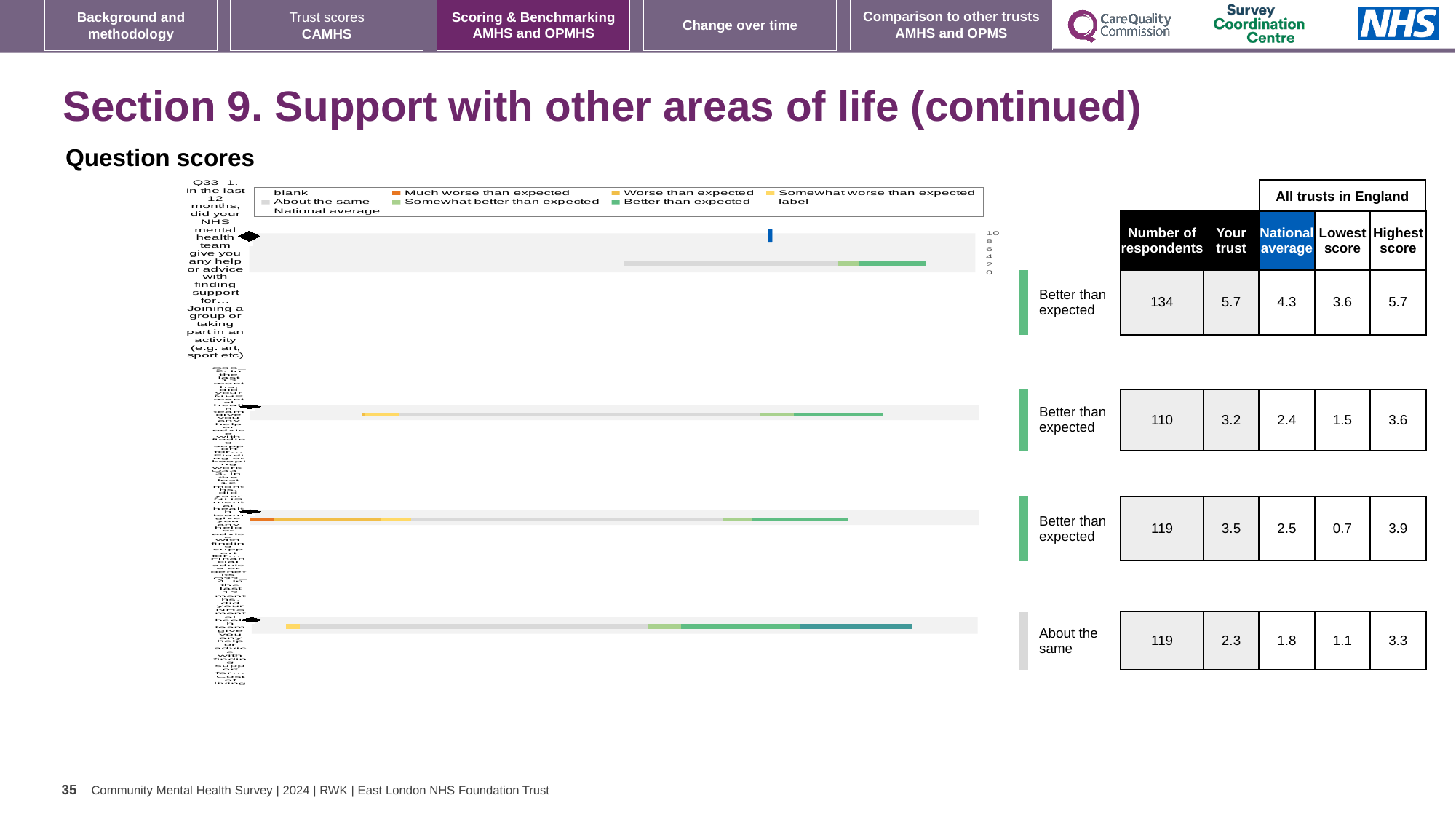
In the table next to the chart, which row has the highest 'Your trust' score? Q33_1 (the first row) What is the highest value shown on the chart's axis? 10 In the table next to the chart, which row has the lowest 'Your trust' score? the fourth (bottom) row In the table next to the chart, is the 'Your trust' score for the first row larger or smaller than the 'Your trust' score for the second row? larger In the table next to the chart, what is the benchmark label for the bottom row? About the same How many question bars are plotted in the chart? 4 In the table next to the chart, how many respondents answered Q33_1 (help finding support for joining a group or taking part in an activity)? 134 In the table next to the chart, what is the national average for Q33_1 (help finding support for joining a group or taking part in an activity)? 4.3 In the table next to the chart, what is the difference between the 'Your trust' score and the national average for Q33_1? 1.4 In the table next to the chart, what is the 'Your trust' score for Q33_1 (help finding support for joining a group or taking part in an activity)? 5.7 What kind of chart is shown under 'Question scores'? bar chart How many entries does the chart legend list? 9